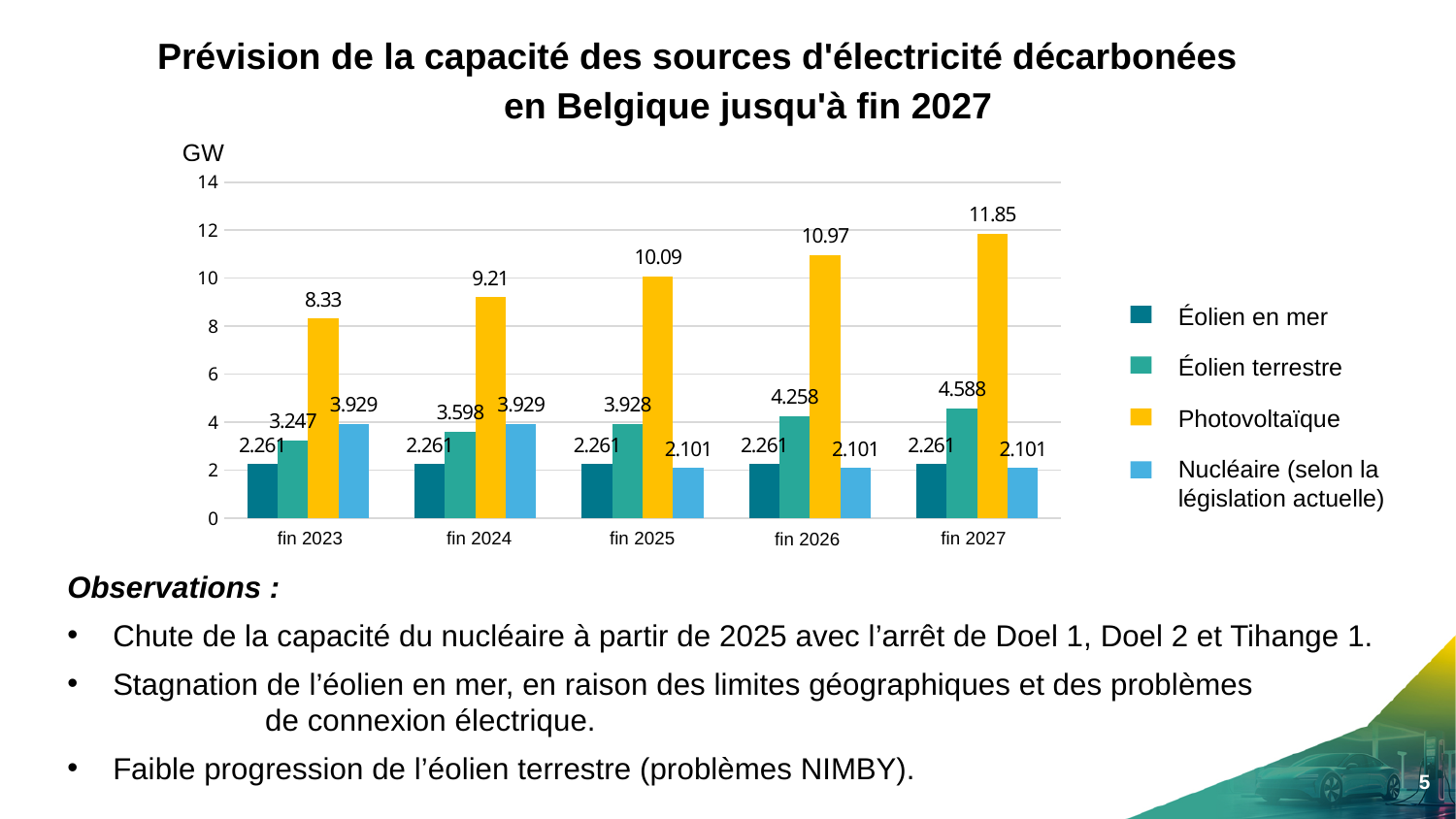
How many series does the legend list? 4 How many year categories are shown on the x axis? 5 What is the Photovoltaïque value for fin 2027? 11.85 What kind of chart is shown on the slide? Bar chart What is the Nucléaire (selon la législation actuelle) value for fin 2024? 3.929 Does the Éolien terrestre value rise or fall from fin 2023 to fin 2027? Rise What is the difference between the Photovoltaïque values for fin 2027 and fin 2023? 3.52 What is the Éolien terrestre value for fin 2025? 3.928 Which is larger in fin 2024: Éolien terrestre or Nucléaire (selon la législation actuelle)? Nucléaire (selon la législation actuelle) What is the Éolien en mer value for fin 2026? 2.261 Which series has the lowest value in fin 2027? Nucléaire (selon la législation actuelle) In which year does Photovoltaïque reach its highest value? fin 2027